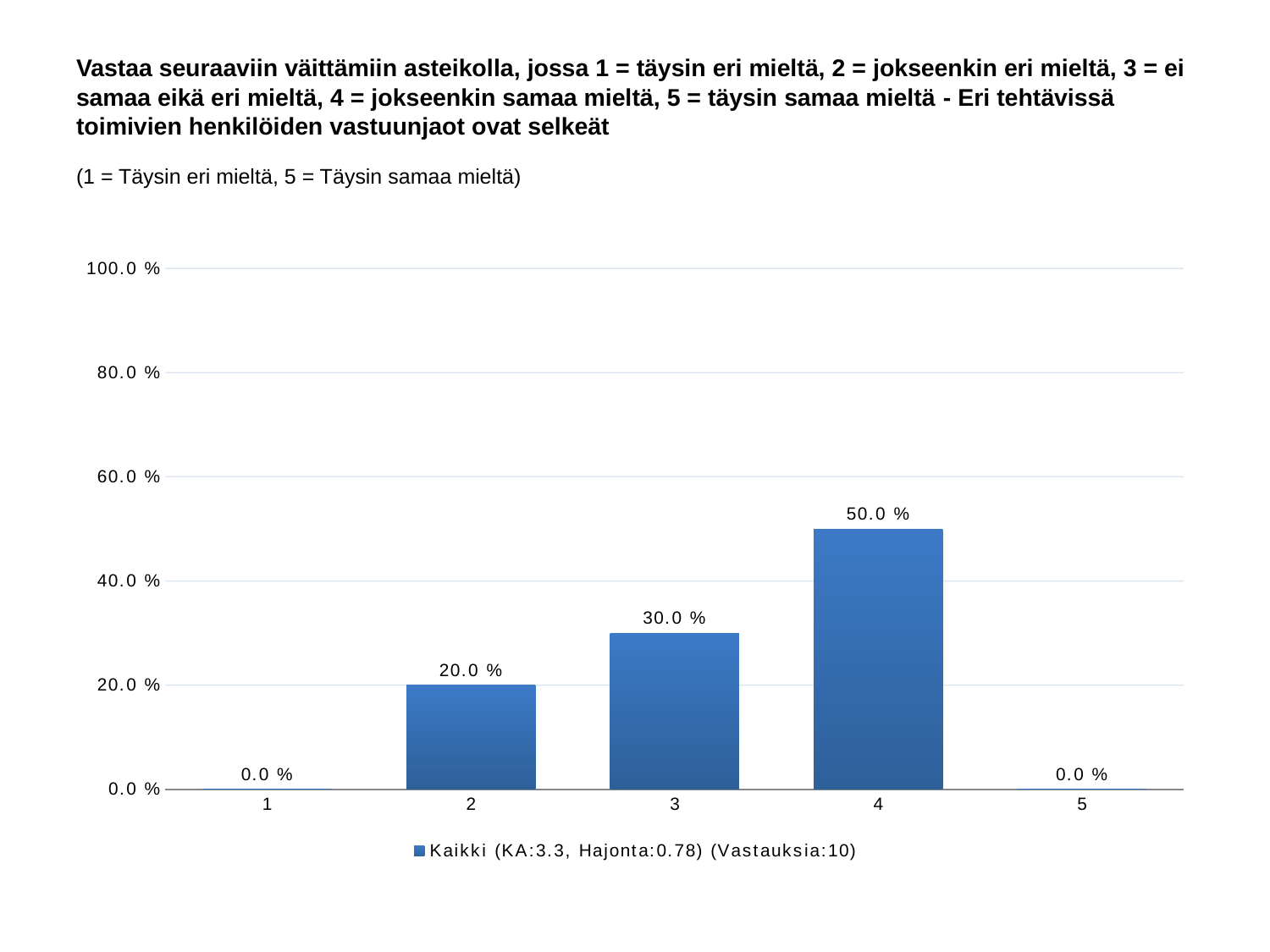
What is the value for category 2? 20.0 % Is the value for category 4 greater or less than 40.0 %? greater What is the value for category 3? 30.0 % What is the difference between the values for category 3 and category 2? 10.0 % How many series does the legend list? 1 What is the difference between the values for category 4 and category 3? 20.0 % Which is larger, the value for category 2 or the value for category 3? 3 Which category has the highest value? 4 What is the value for category 1? 0.0 % How many categories are shown on the x axis? 5 What kind of chart is shown on the slide? bar chart What is the value for category 4? 50.0 %